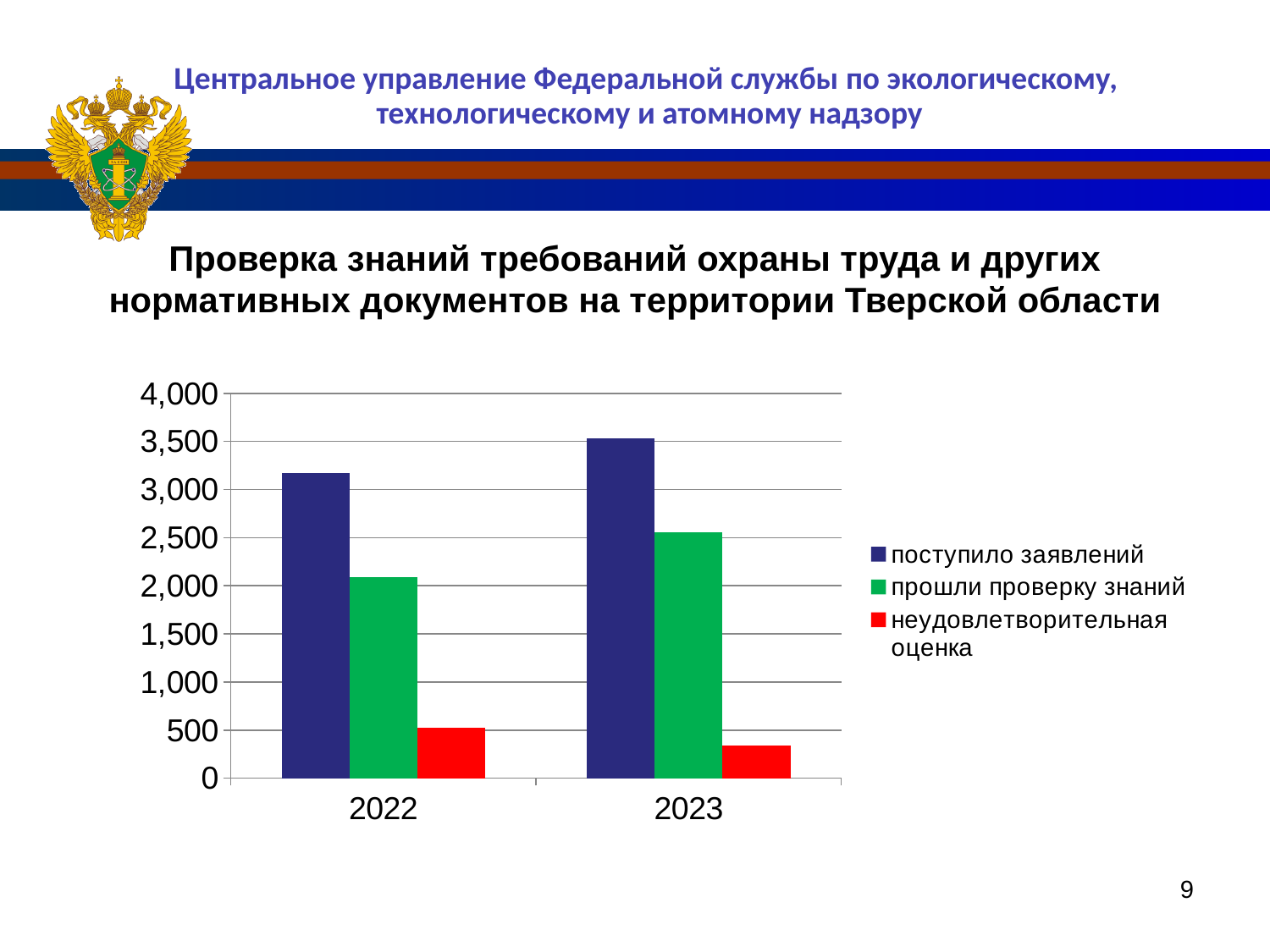
Which year has the higher value for "прошли проверку знаний"? 2023 Is the value for "поступило заявлений" in 2022 greater or less than 3,000? greater Which year has the higher value for "поступило заявлений"? 2023 Is the value for "неудовлетворительная оценка" in 2023 greater or less than 500? less Which year has the lower value for "неудовлетворительная оценка"? 2023 How many series does the legend list? 3 How many years are shown on the x axis? 2 What kind of chart is shown on the slide? bar chart Does the value for "поступило заявлений" rise or fall from 2022 to 2023? rise Is the value for "прошли проверку знаний" in 2022 greater or less than 2,500? less Which series has the lowest values in both years? неудовлетворительная оценка